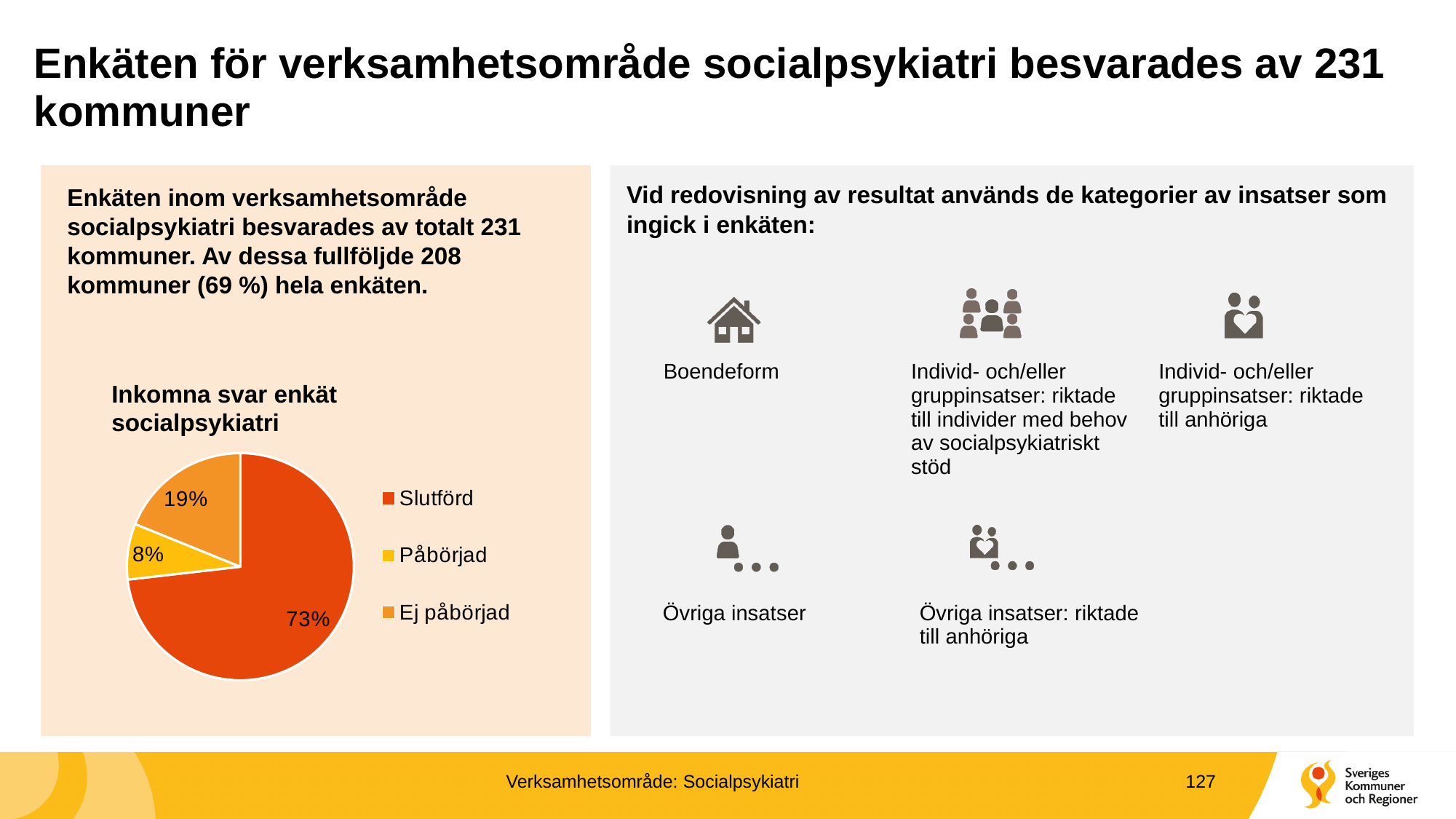
Which is larger, Ej påbörjad or Påbörjad? Ej påbörjad Which category has the largest slice of the pie? Slutförd What share of the pie does Slutförd have? 73% What is the difference in percentage points between Slutförd and Ej påbörjad? 54 What share of the pie does Ej påbörjad have? 19% Which colour represents Påbörjad in the pie chart? Yellow What is the difference in percentage points between Ej påbörjad and Påbörjad? 11 Which category has the smallest slice of the pie? Påbörjad How many categories does the pie chart show? 3 What share of the pie does Påbörjad have? 8% What is the title of the chart? Inkomna svar enkät socialpsykiatri What kind of chart is shown on the slide? Pie chart